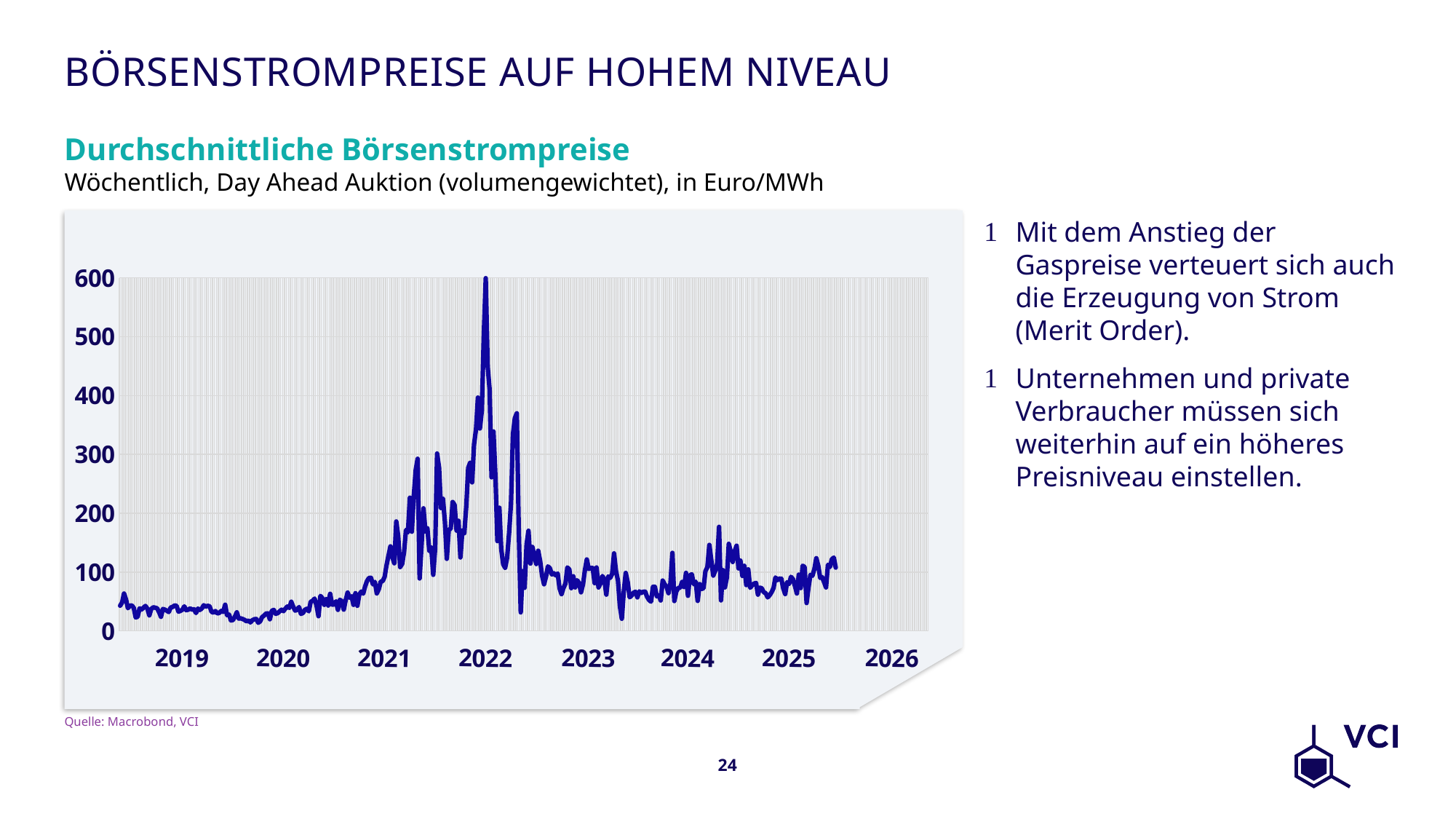
Are the values at the end of the series in 2025 greater or less than 200? less Do the values rise or fall from 2019 to the peak in 2022? rise What is the highest value shown on the y axis? 600 In what unit are the values of the chart given? Euro/MWh Is the highest value of the series greater or less than 500? greater What is the title of the chart? Durchschnittliche Börsenstrompreise Are the values at the start of the series in 2019 greater or less than 100? less Are the values in 2020 higher or lower than the values in 2024? lower In which year does the series reach its highest value? 2022 Do the values rise or fall from the peak in 2022 to 2023? fall What kind of chart is shown on the slide? line chart How many year labels are shown on the x axis? 8